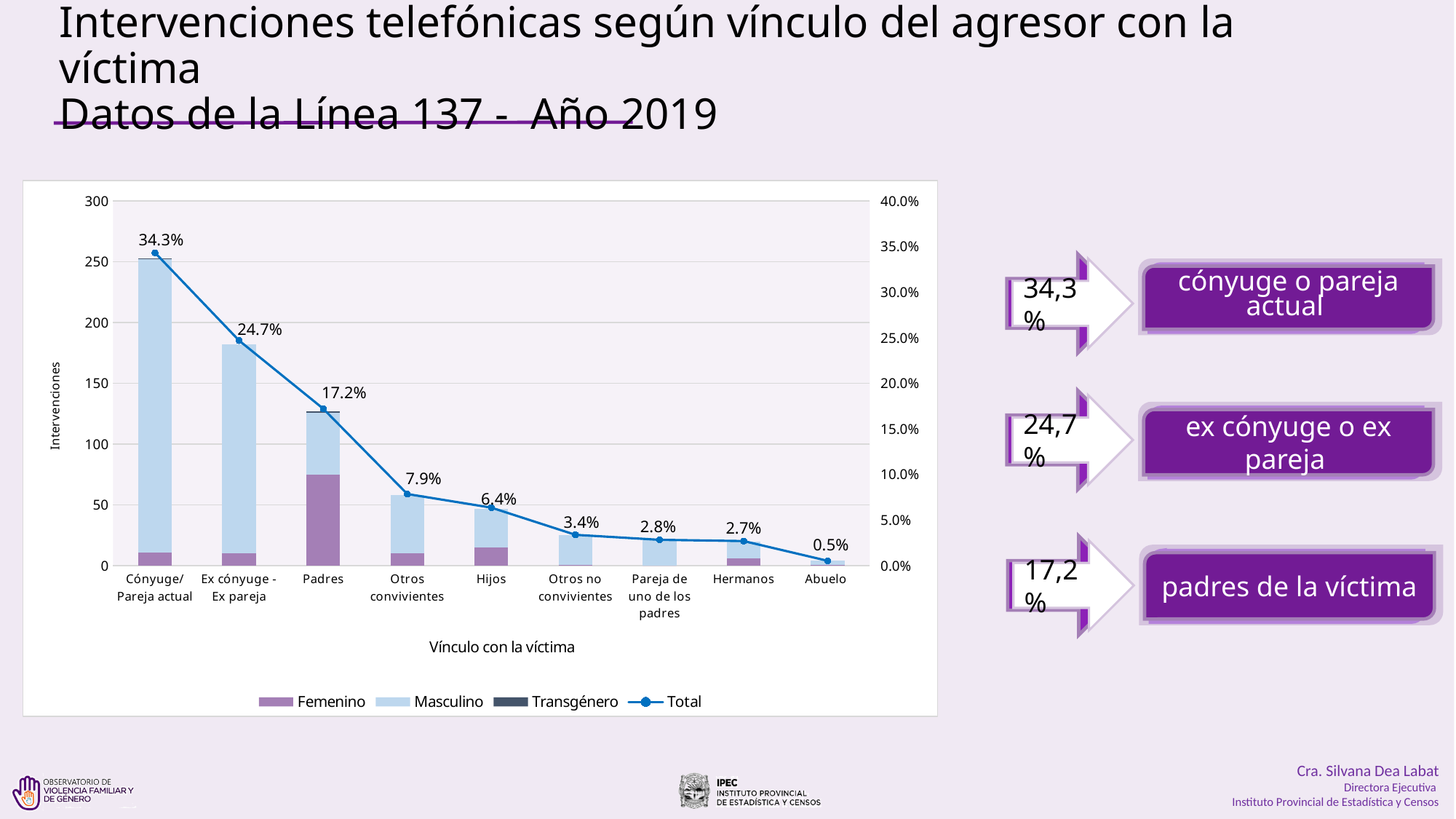
How many categories are shown on the x axis? 9 Which category has the lowest Total percentage? Abuelo Do the Total percentages rise or fall from left to right along the x axis? fall Is the number of interventions for Padres greater or less than 100? greater What is the Total percentage shown for Padres? 17.2% What is the Total percentage shown for Cónyuge/Pareja actual? 34.3% How many series does the legend list? 4 Is the number of interventions for Ex cónyuge - Ex pareja greater or less than 150? greater What is the difference between the Total percentages for Cónyuge/Pareja actual and Ex cónyuge - Ex pareja? 9.6% What is the Total percentage shown for Hijos? 6.4% Which has a higher Total percentage, Otros convivientes or Hijos? Otros convivientes Which category has the highest Total percentage? Cónyuge/Pareja actual